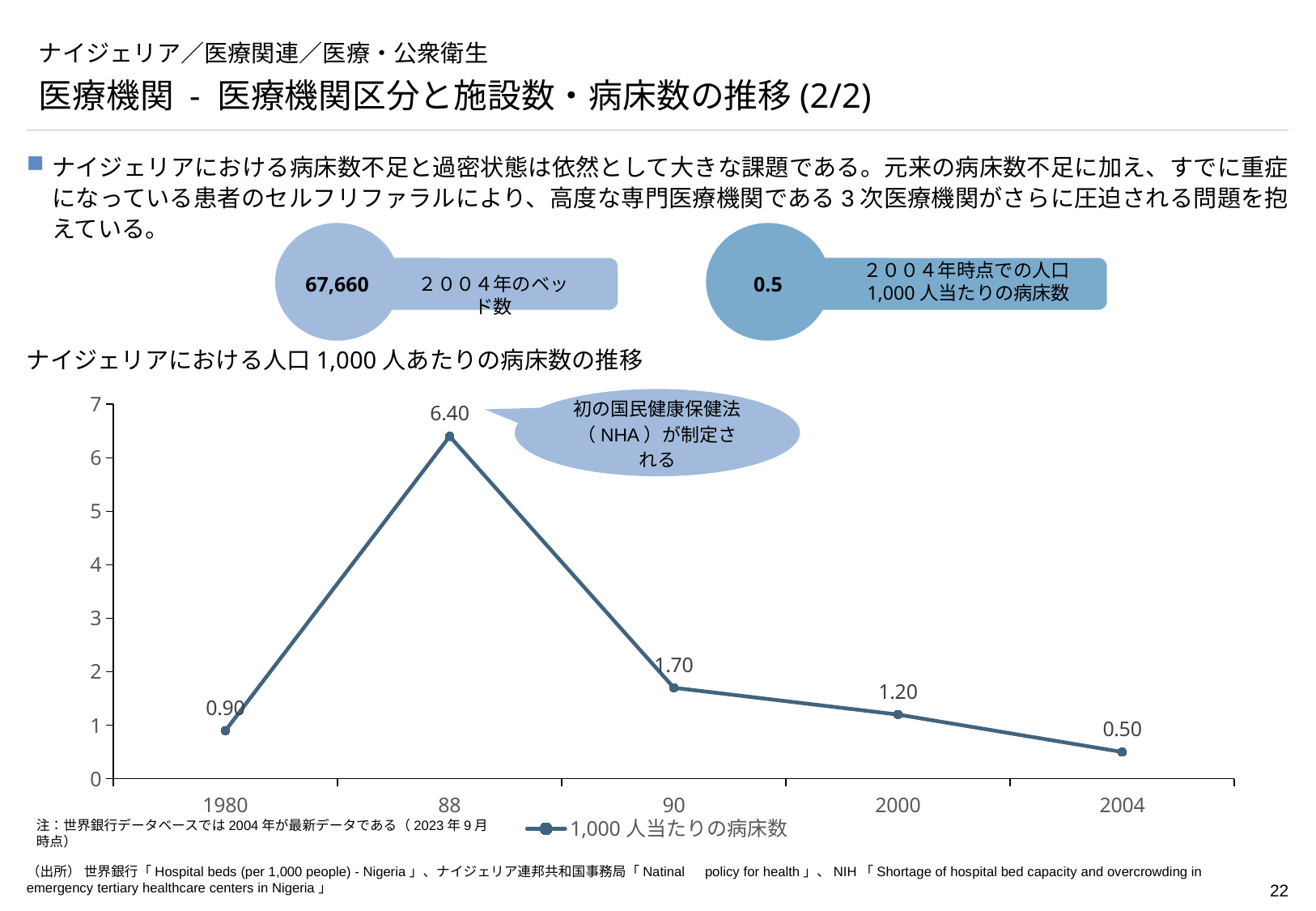
Which is larger in the chart of hospital beds per 1,000 people in Nigeria, the value for 1980 or the value for 2000? 2000 What is the value for 1980 in the chart of hospital beds per 1,000 people in Nigeria? 0.90 How many series does the legend list in the chart of hospital beds per 1,000 people in Nigeria? 1 What is the difference between the values for 88 and 90 in the chart of hospital beds per 1,000 people in Nigeria? 4.70 Is the value for 90 in the chart of hospital beds per 1,000 people in Nigeria greater or less than 2? less How many data points are plotted in the chart of hospital beds per 1,000 people in Nigeria? 5 Which year has the lowest value in the chart of hospital beds per 1,000 people in Nigeria? 2004 What is the value for 2004 in the chart of hospital beds per 1,000 people in Nigeria? 0.50 What kind of chart is used to show hospital beds per 1,000 people in Nigeria? line chart Which year has the highest value in the chart of hospital beds per 1,000 people in Nigeria? 88 Do the values rise or fall from 90 to 2004 in the chart of hospital beds per 1,000 people in Nigeria? fall What is the value for 88 in the chart of hospital beds per 1,000 people in Nigeria? 6.40